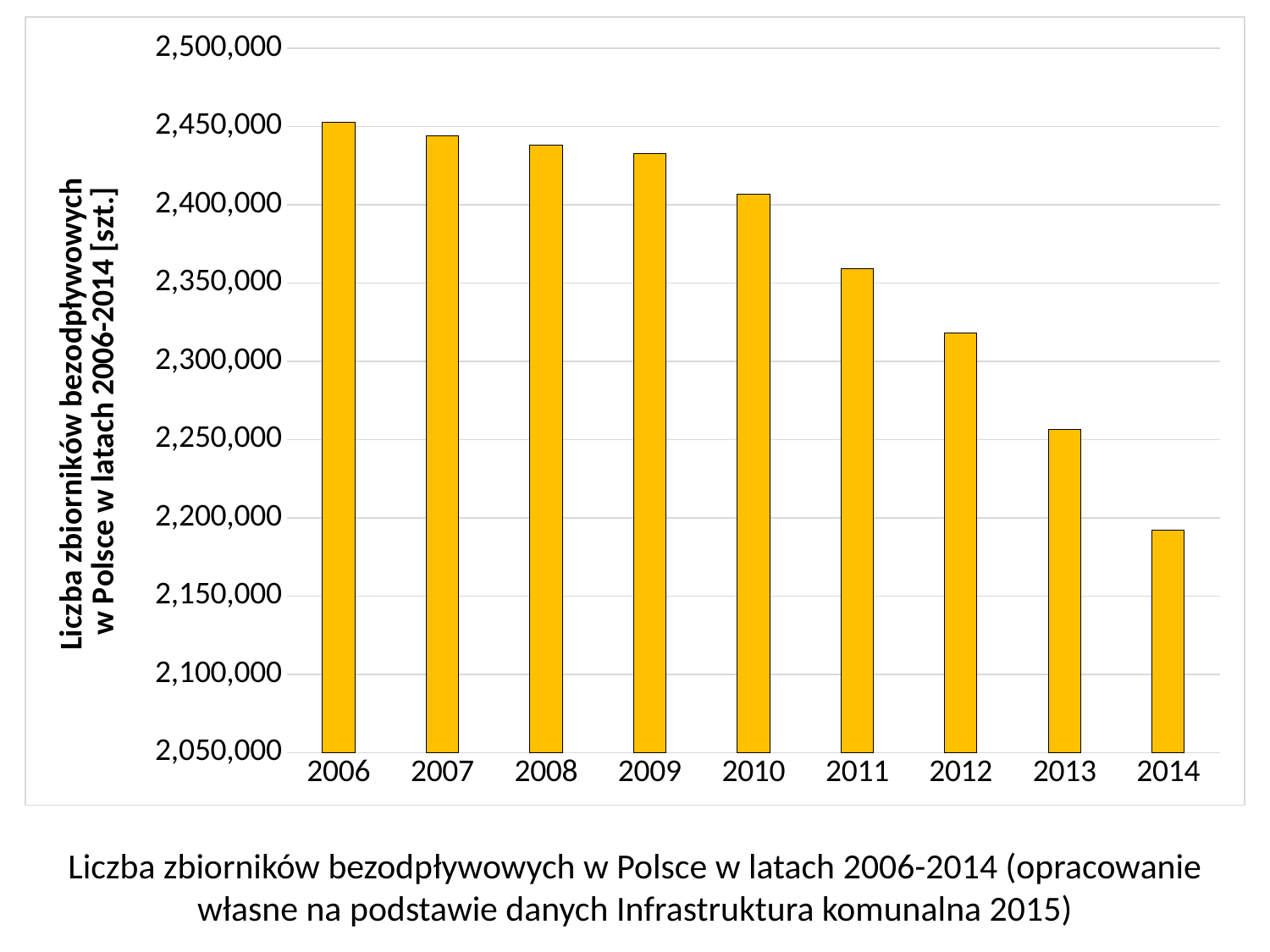
Is the value for 2007 greater or less than 2,450,000? less What kind of chart is shown on the slide? bar chart Which year has the lowest number of cesspools (zbiorniki bezodpływowe)? 2014 Which year has the larger value, 2010 or 2012? 2010 How many years are shown on the x axis of the chart? 9 Is the value for 2012 greater or less than 2,300,000? greater Which year has the highest number of cesspools (zbiorniki bezodpływowe)? 2006 Is the value for 2010 greater or less than 2,400,000? greater What is the unit given in the y-axis label of the chart? szt. Which year has the larger value, 2011 or 2013? 2011 Do the values rise or fall from 2006 to 2014? fall